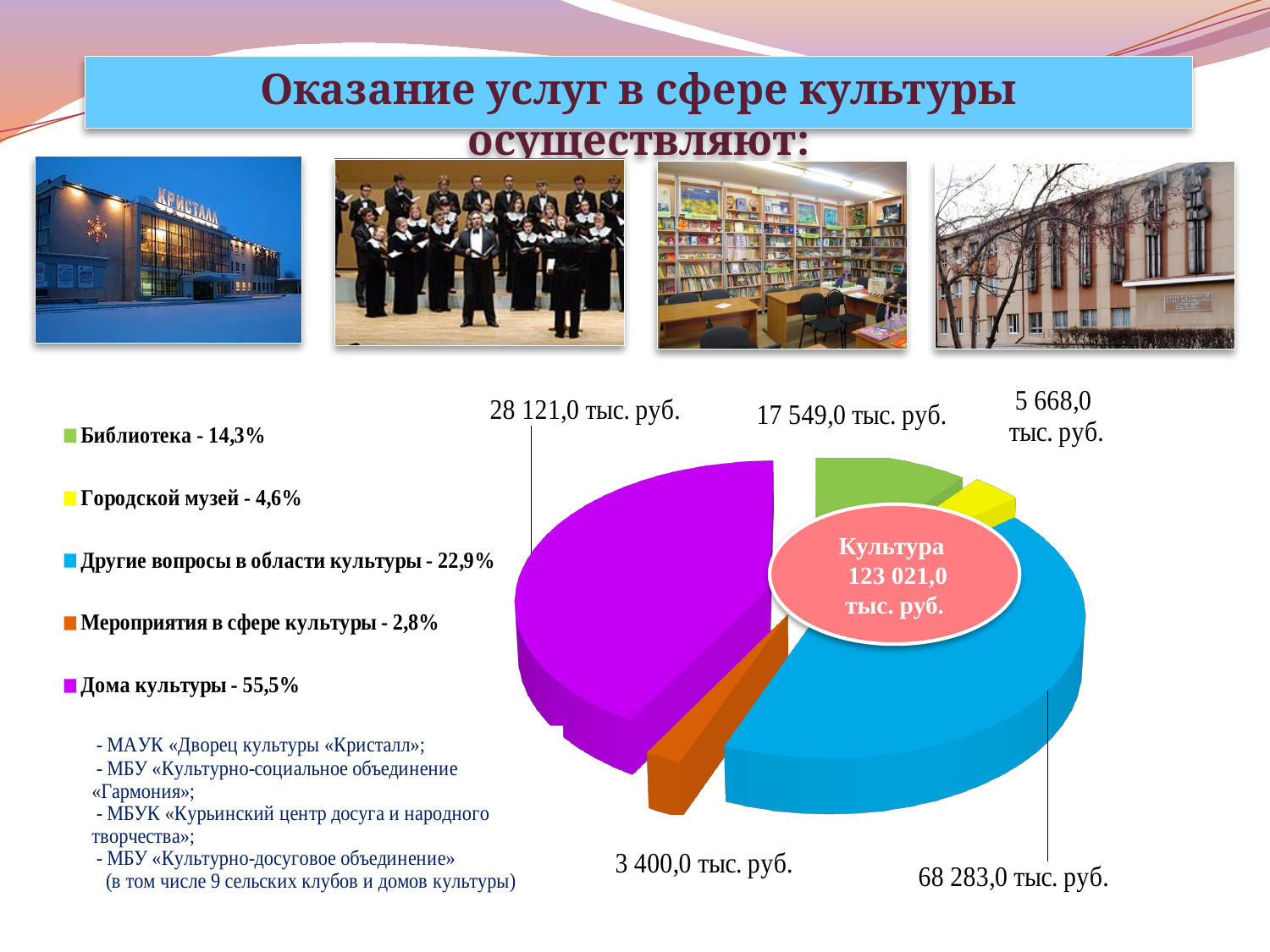
What share does the legend give for Мероприятия в сфере культуры? 2,8% Which has the larger share, Библиотека or Городской музей? Библиотека What share does the legend give for Городской музей? 4,6% What total amount is shown in the oval at the centre of the pie chart? 123 021,0 тыс. руб. What is the largest value labelled on the pie chart? 68 283,0 тыс. руб. What share does the legend give for Дома культуры? 55,5% Which category has the smallest share of the pie? Мероприятия в сфере культуры Which category has the largest share of the pie? Дома культуры What share does the legend give for Библиотека? 14,3% How many categories does the pie chart's legend list? 5 What share does the legend give for Другие вопросы в области культуры? 22,9% What kind of chart is shown on the slide? pie chart